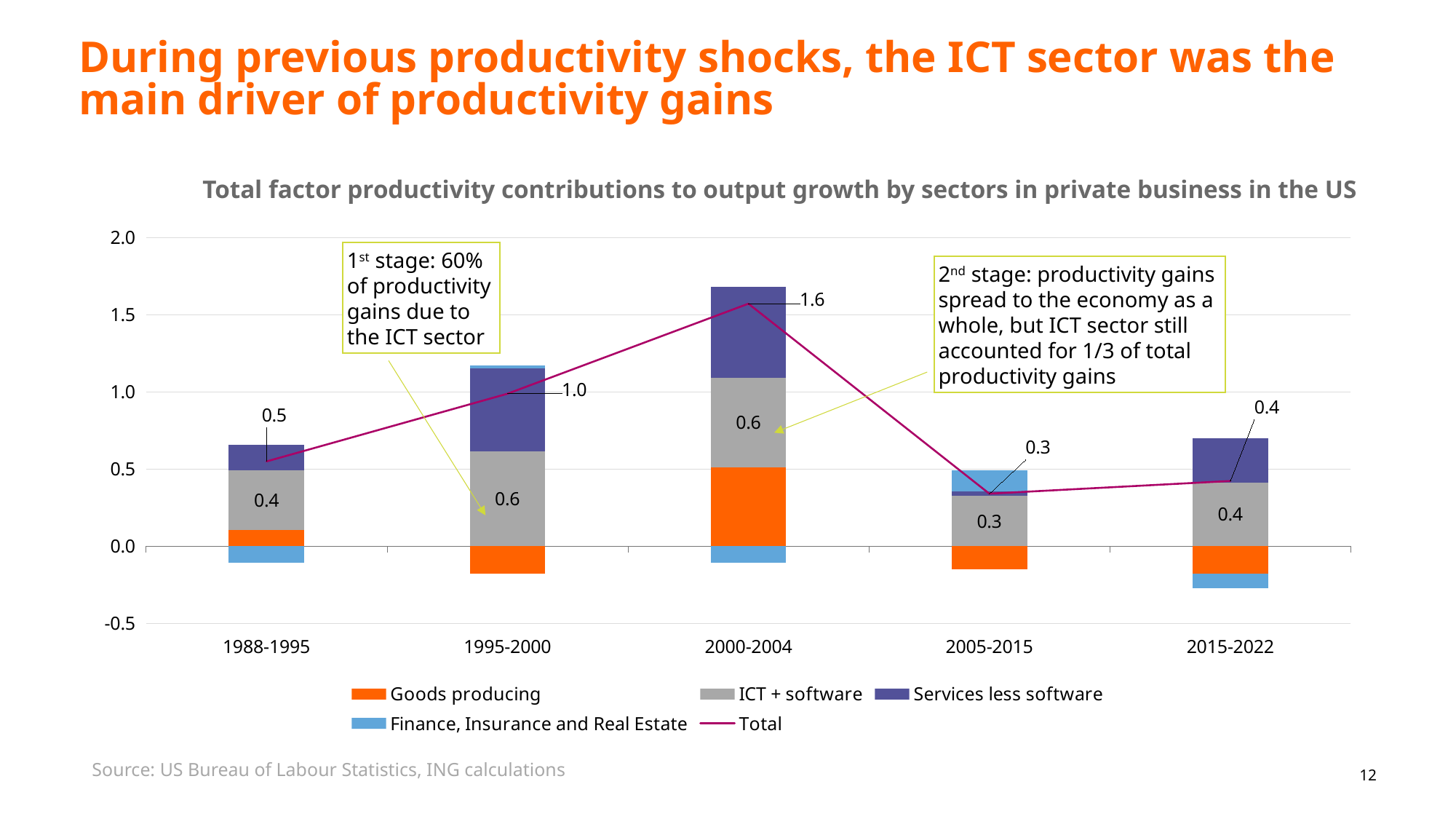
How many series does the legend list? 5 How many time periods are shown on the x axis? 5 In which period is the Total value highest? 2000-2004 In which period is the Total value lowest? 2005-2015 What kind of chart is shown on the slide? A stacked bar chart with a line Does the Total line rise or fall from 1988-1995 to 2000-2004? Rise Is the Finance, Insurance and Real Estate value for 2005-2015 greater or less than 0.5? less What is the ICT + software contribution for 1995-2000? 0.6 Which period has the larger Total value, 1995-2000 or 2015-2022? 1995-2000 What is the difference between the Total value for 2000-2004 and the Total value for 1988-1995? 1.1 What is the Total value for 2005-2015? 0.3 What is the Total value for 2000-2004? 1.6